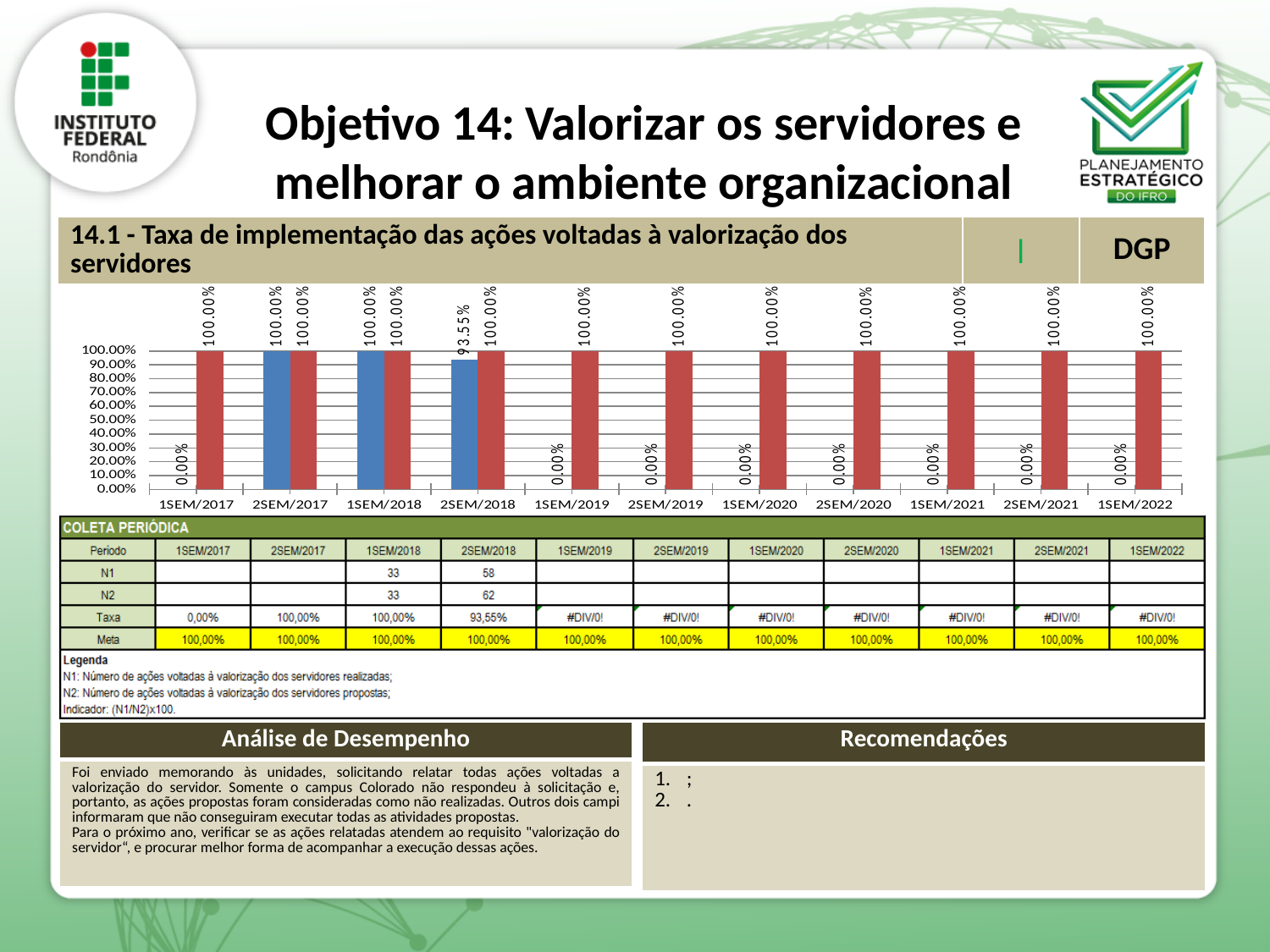
What kind of chart is shown on the slide? bar chart Which is larger for 2SEM/2018, the blue bar or the red bar? the red bar Which period has the lowest blue bar among 2SEM/2017, 1SEM/2018 and 2SEM/2018? 2SEM/2018 What is the value of the blue bar for 2SEM/2017? 100.00% How many periods (categories) are shown on the x axis of the chart? 11 What is the value of the red bar for 1SEM/2022? 100.00% What is the value of the blue bar for 1SEM/2017? 0.00% Do the blue bar values rise or fall from 2SEM/2018 to 1SEM/2019? fall What is the difference between the red bar and the blue bar for 2SEM/2018? 6.45% What is the title of the indicator shown above the chart? 14.1 - Taxa de implementação das ações voltadas à valorização dos servidores Is the value of the blue bar for 2SEM/2018 greater or less than 90.00%? greater What is the value of the blue bar for 2SEM/2018? 93.55%